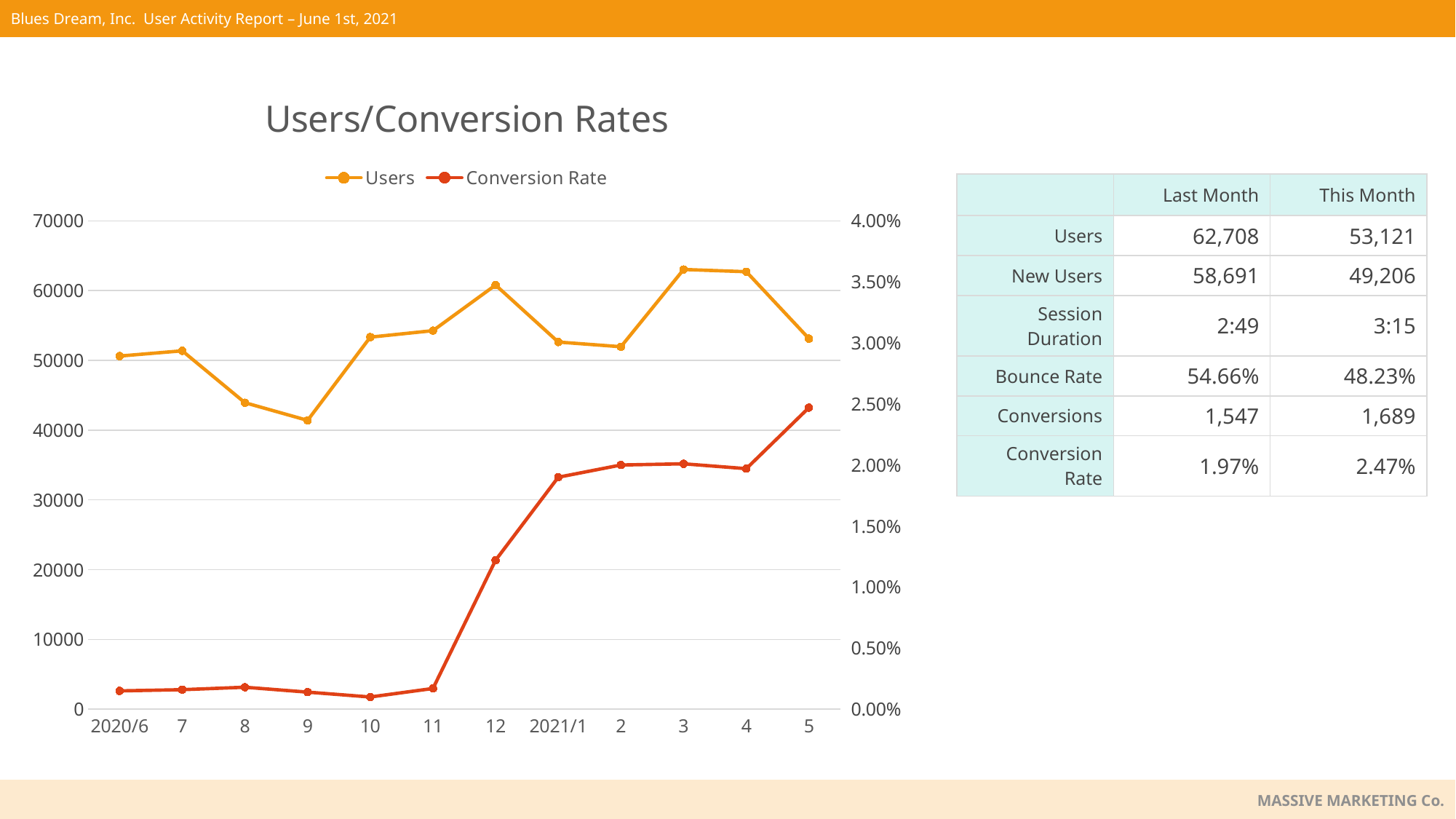
How many months are plotted along the x axis of the chart? 12 What kind of chart is shown on the slide? Line chart Which month has more Users, 2020/6 or 10? 10 Is the Conversion Rate for 2021/1 greater or less than 1.50%? greater How many series does the chart legend list? 2 Is the Users value for month 9 greater or less than 50000? less In which month is the Users series at its lowest? 9 Is the Users value for month 3 (2021) greater or less than 60000? greater In which month is the Conversion Rate series at its highest? 5 What is the title of the chart? Users/Conversion Rates Does the Conversion Rate rise or fall between month 11 and 2021/1? rise